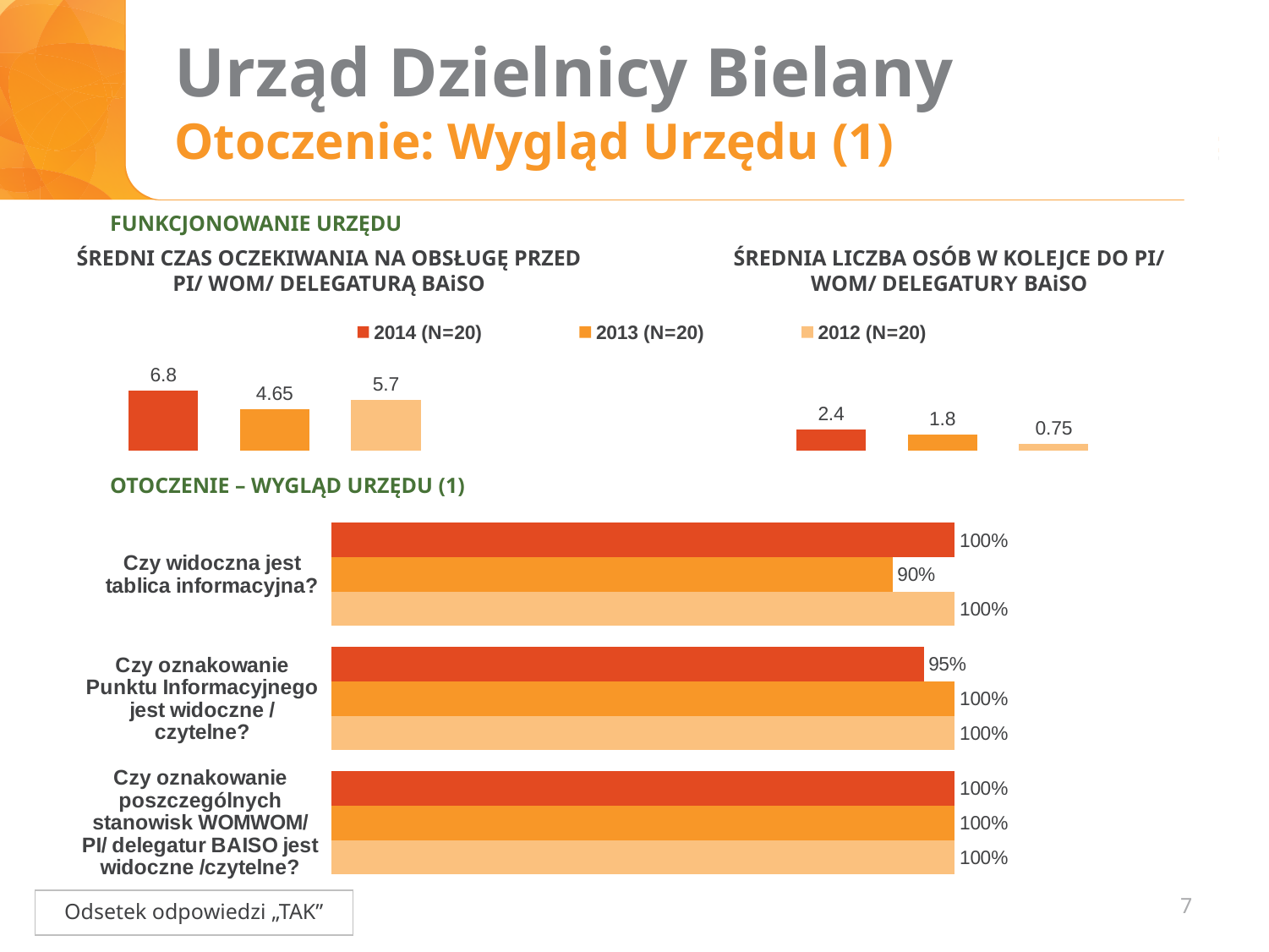
In the chart 'ŚREDNIA LICZBA OSÓB W KOLEJCE DO PI/ WOM/ DELEGATURY BAiSO', what is the difference between the 2014 and 2013 values? 0.6 In the bottom chart 'OTOCZENIE – WYGLĄD URZĘDU (1)', what is the 2013 value for 'Czy widoczna jest tablica informacyjna?'? 90% How many series does the legend list for the charts on this slide? 3 In the bottom chart 'OTOCZENIE – WYGLĄD URZĘDU (1)', how many question categories are shown? 3 In the chart 'ŚREDNIA LICZBA OSÓB W KOLEJCE DO PI/ WOM/ DELEGATURY BAiSO', what is the value for 2012 (N=20)? 0.75 In the chart 'ŚREDNI CZAS OCZEKIWANIA NA OBSŁUGĘ PRZED PI/ WOM/ DELEGATURĄ BAiSO', what is the difference between the 2014 and 2012 values? 1.1 What type of chart is the bottom chart 'OTOCZENIE – WYGLĄD URZĘDU (1)'? bar chart In the chart 'ŚREDNI CZAS OCZEKIWANIA NA OBSŁUGĘ PRZED PI/ WOM/ DELEGATURĄ BAiSO', what is the value for 2014 (N=20)? 6.8 In the bottom chart 'OTOCZENIE – WYGLĄD URZĘDU (1)', what is the 2014 value for 'Czy oznakowanie Punktu Informacyjnego jest widoczne / czytelne?'? 95% In the chart 'ŚREDNI CZAS OCZEKIWANIA NA OBSŁUGĘ PRZED PI/ WOM/ DELEGATURĄ BAiSO', which year has the lowest value? 2013 (N=20) In the chart 'ŚREDNIA LICZBA OSÓB W KOLEJCE DO PI/ WOM/ DELEGATURY BAiSO', which year has the highest value? 2014 (N=20) In the chart 'ŚREDNIA LICZBA OSÓB W KOLEJCE DO PI/ WOM/ DELEGATURY BAiSO', do the values rise or fall from 2014 to 2012? fall